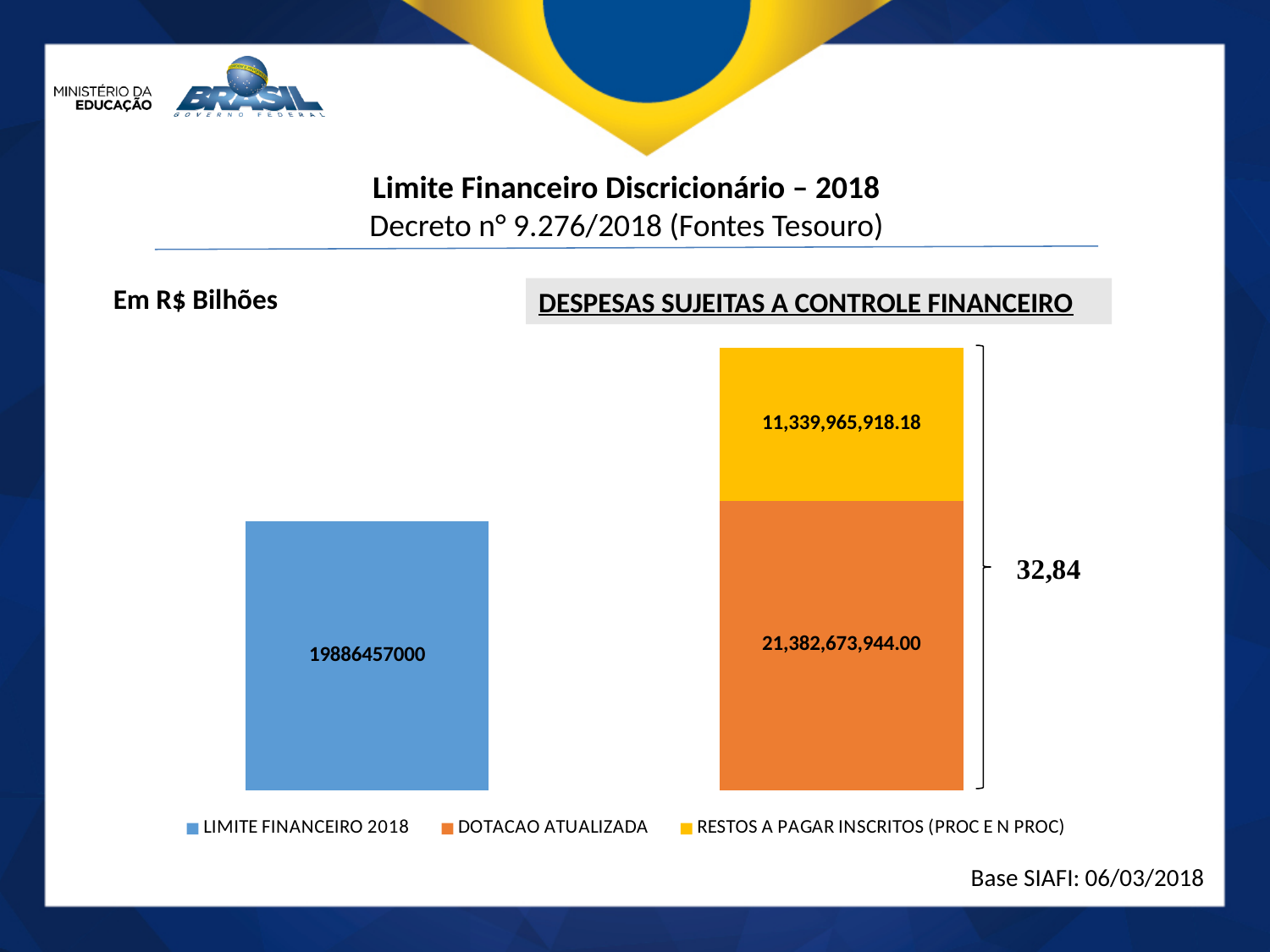
What unit is stated above the chart? Em R$ Bilhões What colour represents DOTACAO ATUALIZADA in the chart? Orange How many series does the legend list? 3 What total is annotated with the bracket next to the stacked bar? 32,84 Which is larger, LIMITE FINANCEIRO 2018 or RESTOS A PAGAR INSCRITOS (PROC E N PROC)? LIMITE FINANCEIRO 2018 What value is shown on the LIMITE FINANCEIRO 2018 bar? 19886457000 What kind of chart is shown on the slide? Bar chart Which of the three legend series has the smallest value? RESTOS A PAGAR INSCRITOS (PROC E N PROC) Which is larger, DOTACAO ATUALIZADA or LIMITE FINANCEIRO 2018? DOTACAO ATUALIZADA What is the difference between DOTACAO ATUALIZADA and RESTOS A PAGAR INSCRITOS (PROC E N PROC)? 10,042,708,025.82 What value is shown for RESTOS A PAGAR INSCRITOS (PROC E N PROC)? 11,339,965,918.18 What value is shown for DOTACAO ATUALIZADA in the stacked bar? 21,382,673,944.00